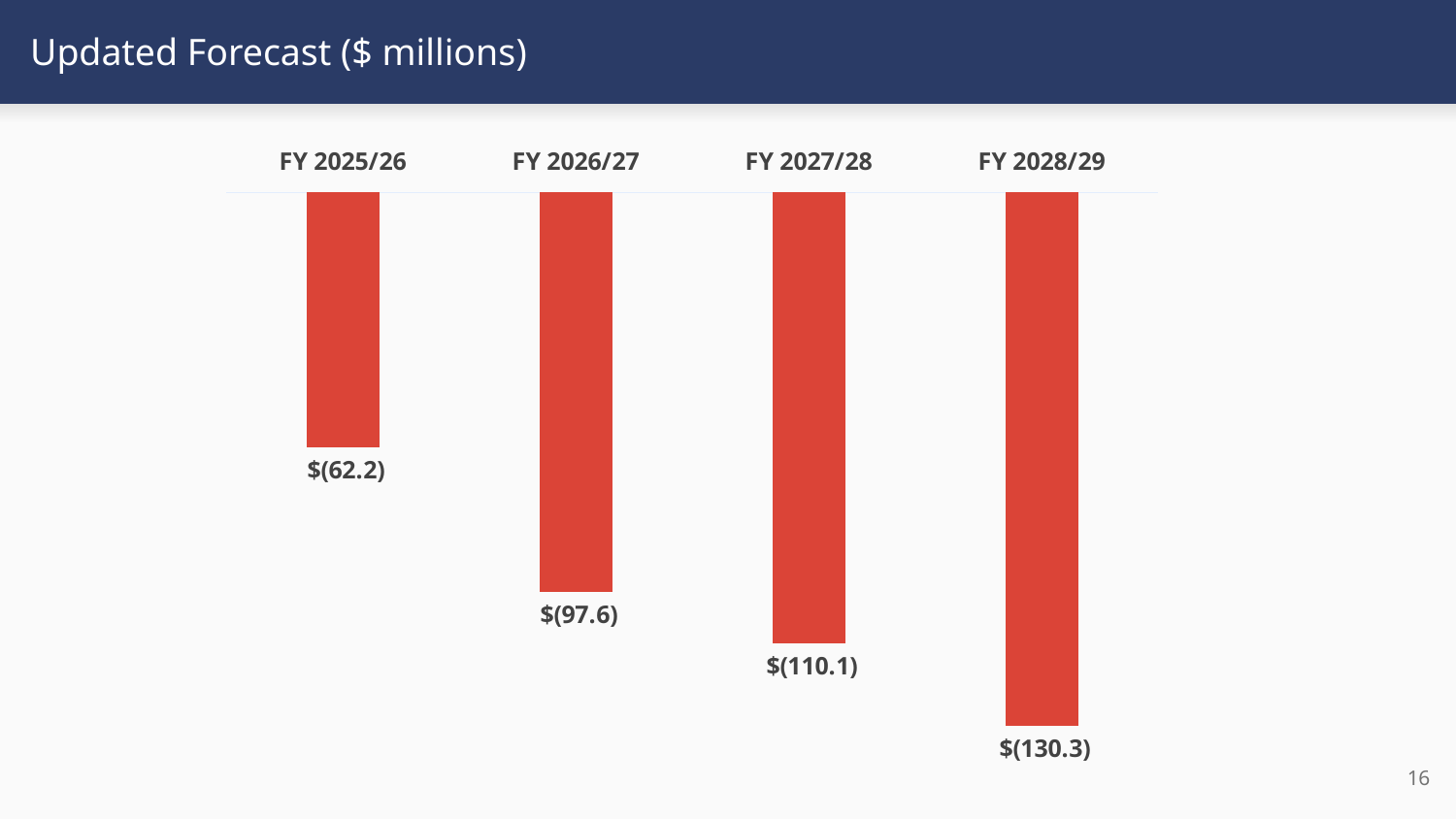
What is the value for FY 2025/26? $(62.2) Which fiscal year has the largest deficit (the longest bar)? FY 2028/29 How many fiscal years are shown in the chart? 4 By how much does the deficit for FY 2028/29 exceed the deficit for FY 2025/26, in $ millions? 68.1 What is the difference between the FY 2027/28 and FY 2026/27 values, in $ millions? 12.5 What is the value for FY 2028/29? $(130.3) Which fiscal year has the smallest deficit (the shortest bar)? FY 2025/26 What is the value for FY 2027/28? $(110.1) What type of chart is shown on the slide? Bar chart Do the deficits grow or shrink from FY 2025/26 to FY 2028/29? Grow Which has the larger deficit, FY 2026/27 or FY 2027/28? FY 2027/28 What is the value for FY 2026/27? $(97.6)